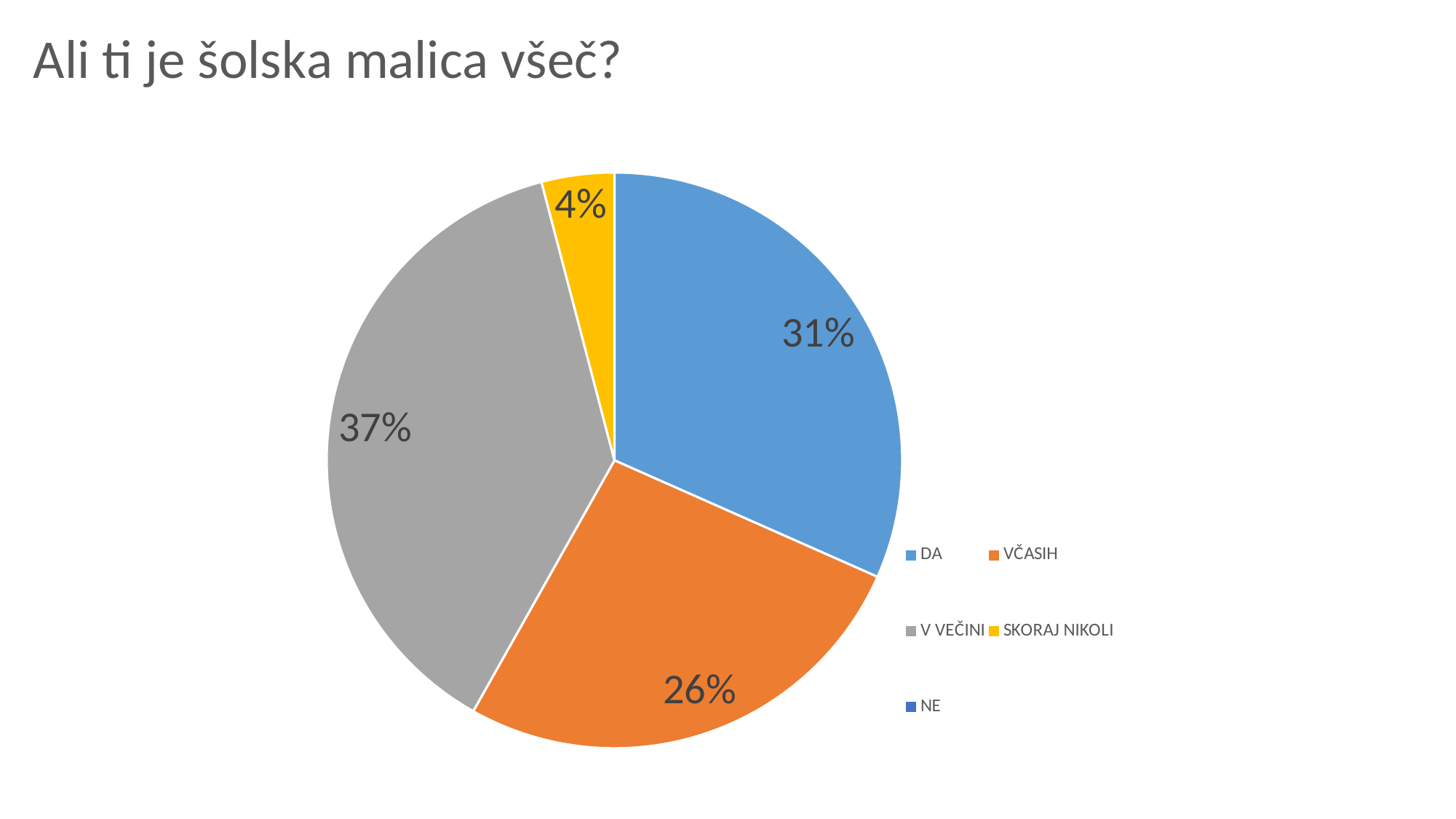
What percentage is shown for the SKORAJ NIKOLI slice? 4% Which labelled slice has the smallest share of the pie? SKORAJ NIKOLI What percentage is shown for the V VEČINI slice? 37% How many entries does the legend list? 5 What colour is the V VEČINI slice? Gray What percentage is shown for the VČASIH slice? 26% What is the title of the slide? Ali ti je šolska malica všeč? What is the difference in percentage points between the V VEČINI and DA slices? 6 Which slice is larger, DA or VČASIH? DA What type of chart is shown on the slide? Pie chart What percentage of the pie is the DA slice? 31% Which category has the largest share of the pie? V VEČINI